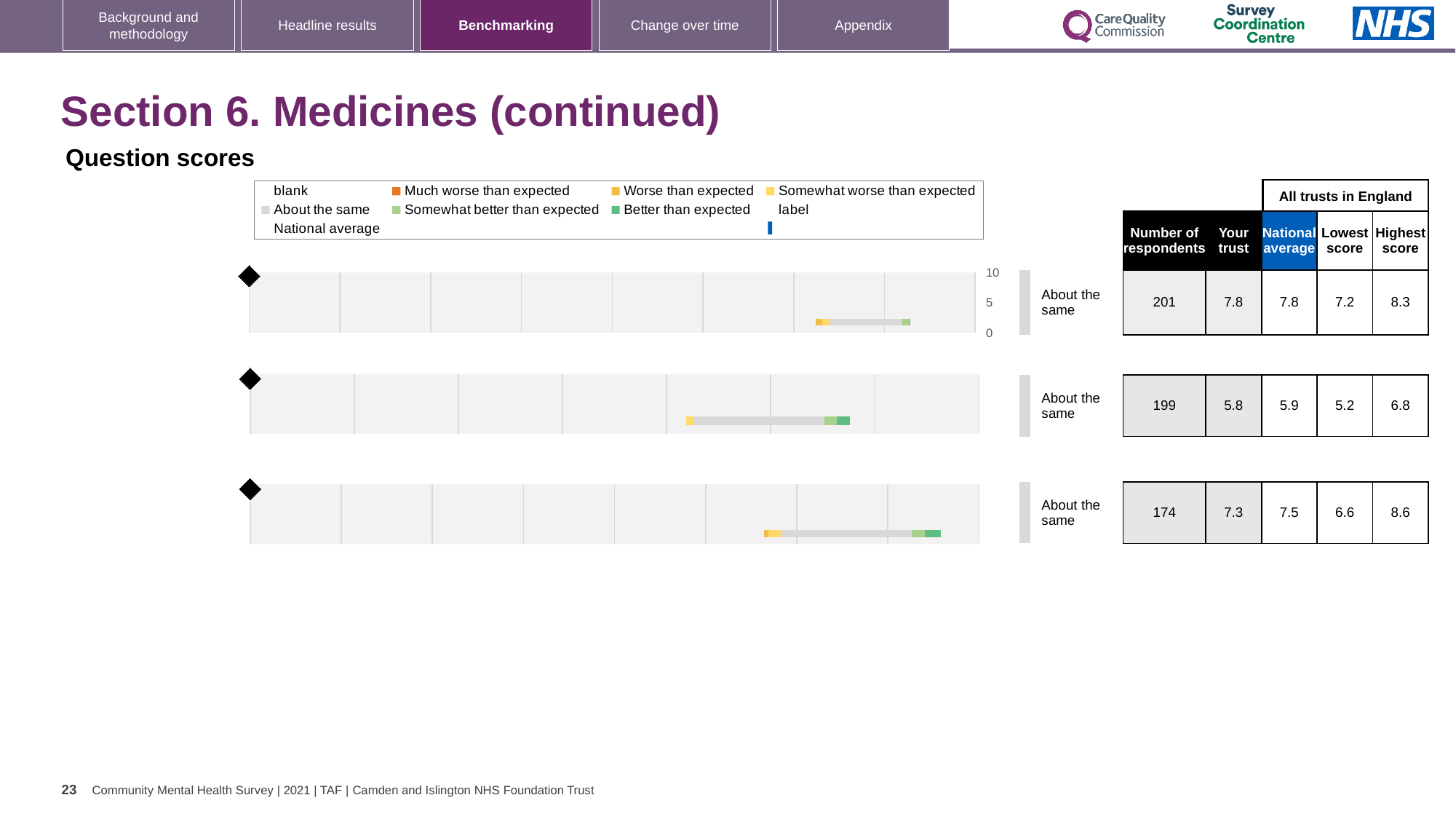
What is the maximum value shown on the vertical axis scale next to the top chart? 10 What kind of chart is used for the three question score charts on the slide? bar chart In the top chart, is the plotted range of scores greater or less than 5? greater For the bottom chart, what is the highest score shown in the table beside it? 8.6 For the bottom chart, what is the number of respondents shown in the table beside it? 174 Which legend entry is shown in orange? Much worse than expected For the middle chart, what is the difference between the highest score and the lowest score? 1.6 For the middle chart, what is the national average shown in the table beside it? 5.9 For the top chart, what is the 'Your trust' score shown in the table beside it? 7.8 What benchmark category is given for the middle chart? About the same How many question score charts are shown on the slide? 3 For the bottom chart, is the 'Your trust' score larger or smaller than the national average? smaller